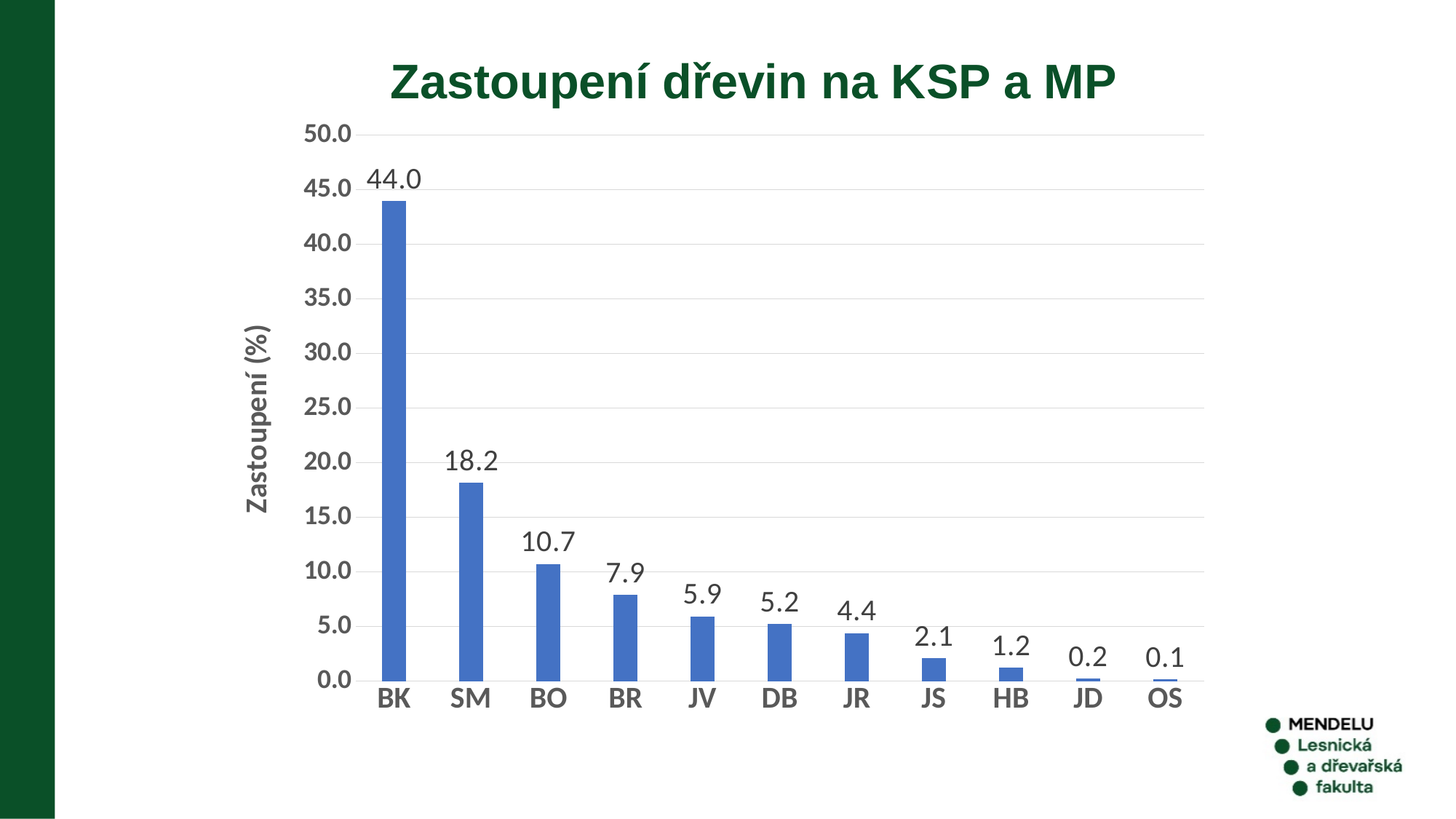
What kind of chart is shown on the slide? bar chart How many categories are shown on the x axis? 11 What is the value for BK? 44.0 What is the value for BO? 10.7 What is the difference between the values for BK and SM? 25.8 What is the value for JS? 2.1 What is the difference between the values for BR and JV? 2.0 What is the title of the chart? Zastoupení dřevin na KSP a MP Which category has the lowest value? OS Which is larger, the value for DB or the value for JR? DB Is the value for SM greater or less than 20.0? less Which category has the highest value? BK